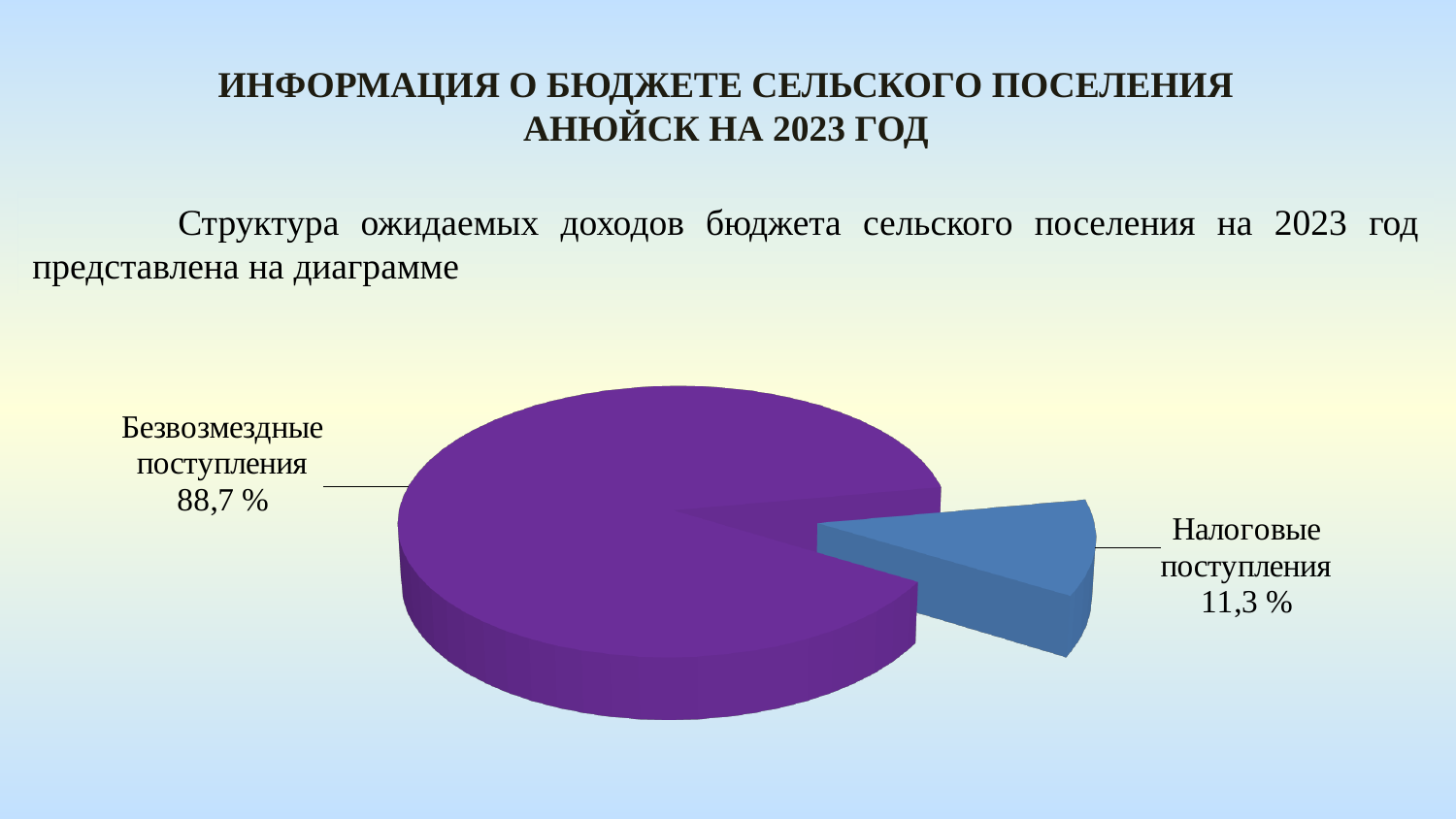
What colour is the slice for Налоговые поступления? Blue What is the difference in percentage points between Безвозмездные поступления and Налоговые поступления? 77,4 % What share of the pie does Безвозмездные поступления have? 88,7 % How many slices does the pie chart have? 2 What colour is the slice for Безвозмездные поступления? Purple Which is larger: Безвозмездные поступления or Налоговые поступления? Безвозмездные поступления Which slice of the pie is the smallest? Налоговые поступления What kind of chart is shown on the slide? Pie chart What share of the pie does Налоговые поступления have? 11,3 % Which slice of the pie is the largest? Безвозмездные поступления